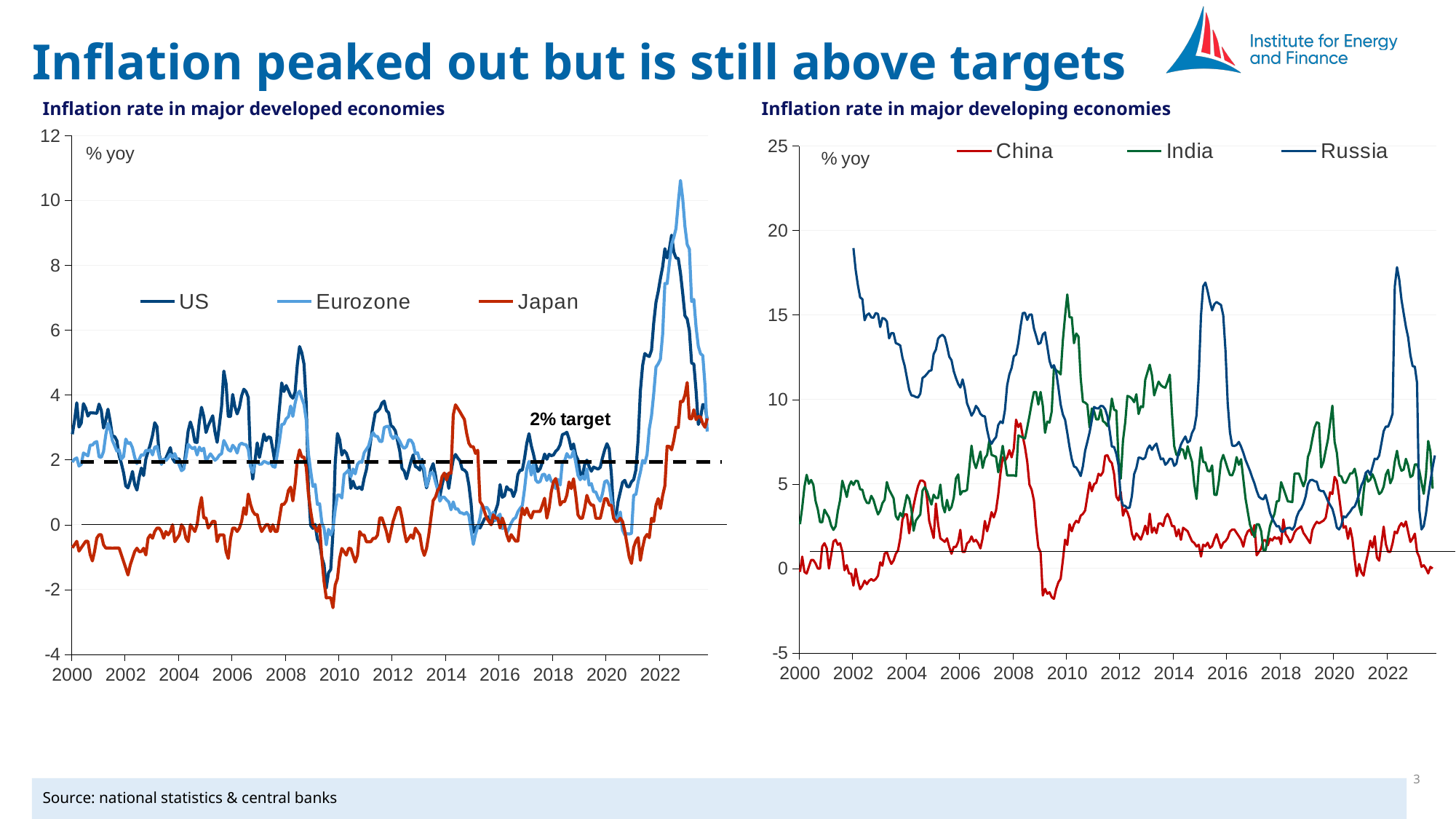
In the 'Inflation rate in major developed economies' chart, is the peak value for Eurozone in 2022 greater or less than 10? greater In the 'Inflation rate in major developing economies' chart, which series reached the highest value over the whole period? Russia In the 'Inflation rate in major developed economies' chart, what level does the dashed horizontal line mark? 2% target In the 'Inflation rate in major developing economies' chart, does the value for Russia rise or fall between 2000 and 2006? fall What kind of chart is the 'Inflation rate in major developed economies' chart? line chart In the 'Inflation rate in major developed economies' chart, which series was mostly below 0 in the early 2000s? Japan In the 'Inflation rate in major developed economies' chart, which series reached the highest peak over the whole period? Eurozone How many series does the legend of the 'Inflation rate in major developed economies' chart list? 3 In the 'Inflation rate in major developing economies' chart, is the peak value for China around 2008 greater or less than 10? less In the 'Inflation rate in major developing economies' chart, which series dropped below 0 around 2009? China Which series does the legend of the 'Inflation rate in major developing economies' chart list? China, India, Russia